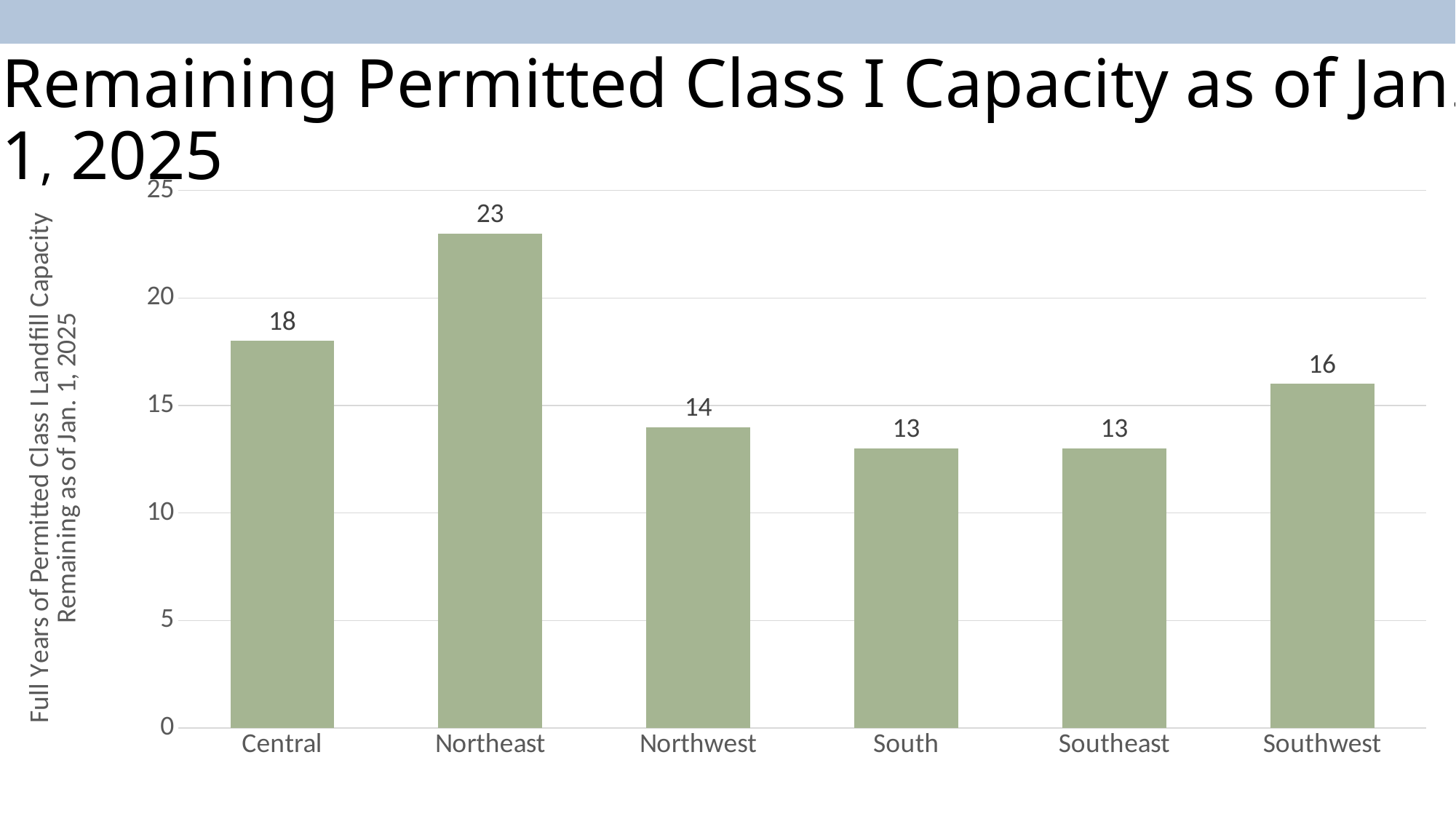
How many regions are shown on the x axis? 6 What is the value for Southwest? 16 Which is larger, the value for Central or the value for Southwest? Central What kind of chart is shown on the slide? bar chart Which region has the highest value? Northeast Which two regions share the same value of 13? South and Southeast What is the value for Northeast? 23 Is the value for Northeast greater or less than 20? greater What is the value for Central? 18 What is the difference between the values for Southwest and Northwest? 2 What is the label of the vertical axis? Full Years of Permitted Class I Landfill Capacity Remaining as of Jan. 1, 2025 What is the difference between the values for Northeast and Central? 5